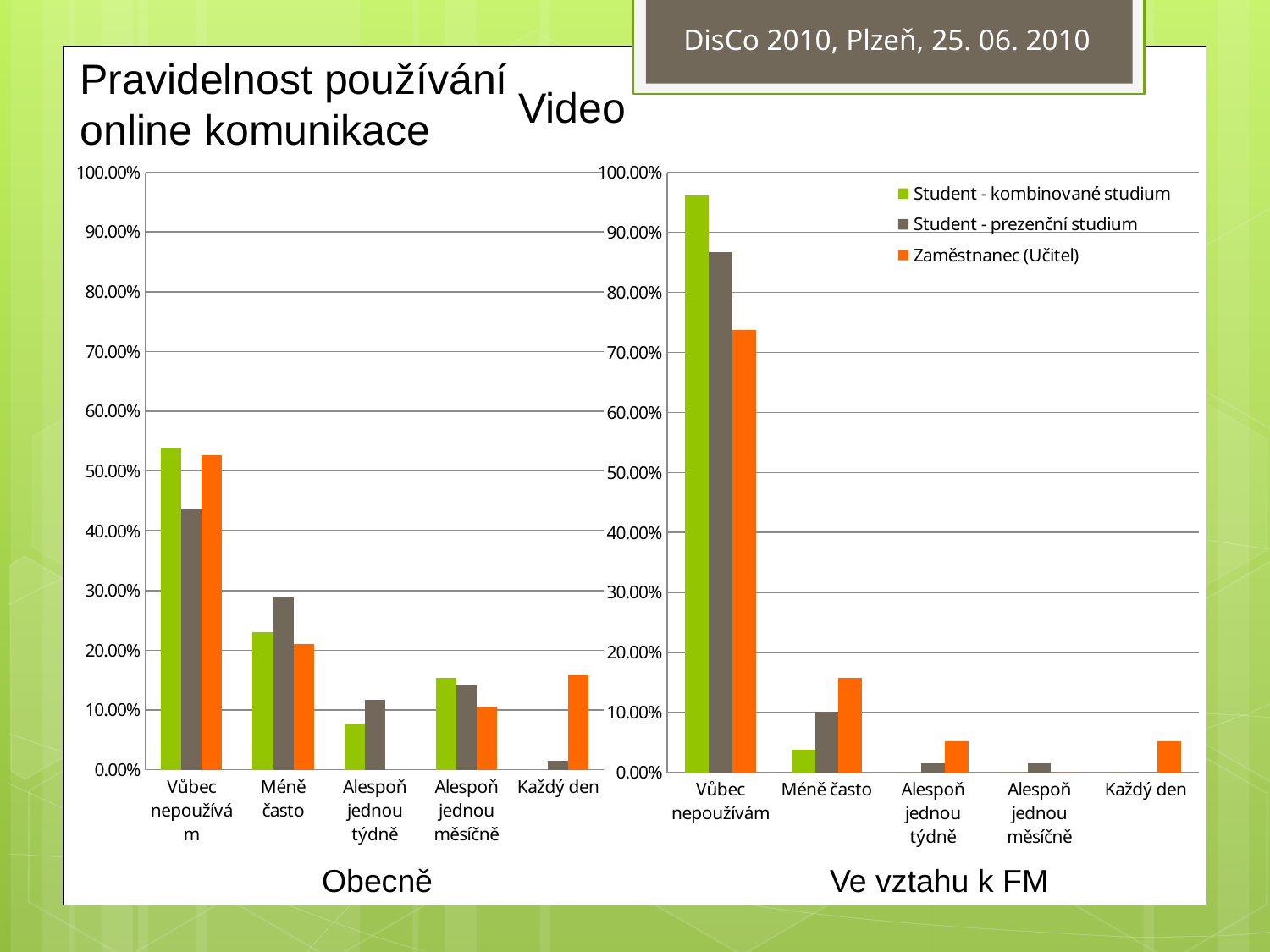
In the right chart ("Ve vztahu k FM"), which series has the lowest bar in the "Vůbec nepoužívám" category? Zaměstnanec (Učitel) In the left chart ("Obecně"), is the value for Student - prezenční studium in the "Vůbec nepoužívám" category greater or less than 50.00%? less In the left chart ("Obecně"), for the "Méně často" category, which is larger: Student - prezenční studium or Zaměstnanec (Učitel)? Student - prezenční studium What type of chart is the right chart titled "Ve vztahu k FM"? bar chart In the right chart ("Ve vztahu k FM"), for the "Vůbec nepoužívám" category, which is larger: Student - kombinované studium or Zaměstnanec (Učitel)? Student - kombinované studium What colour represents the series Zaměstnanec (Učitel) in the legend? orange How many categories are shown on the x axis of the left chart titled "Obecně"? 5 How many series does the legend on the right chart ("Ve vztahu k FM") list? 3 In the left chart ("Obecně"), is the value for Zaměstnanec (Učitel) in the "Každý den" category greater or less than 10.00%? greater In the right chart ("Ve vztahu k FM"), is the value for Zaměstnanec (Učitel) in the "Vůbec nepoužívám" category greater or less than 70.00%? greater In the left chart ("Obecně"), which category has the highest bar for Student - kombinované studium? Vůbec nepoužívám